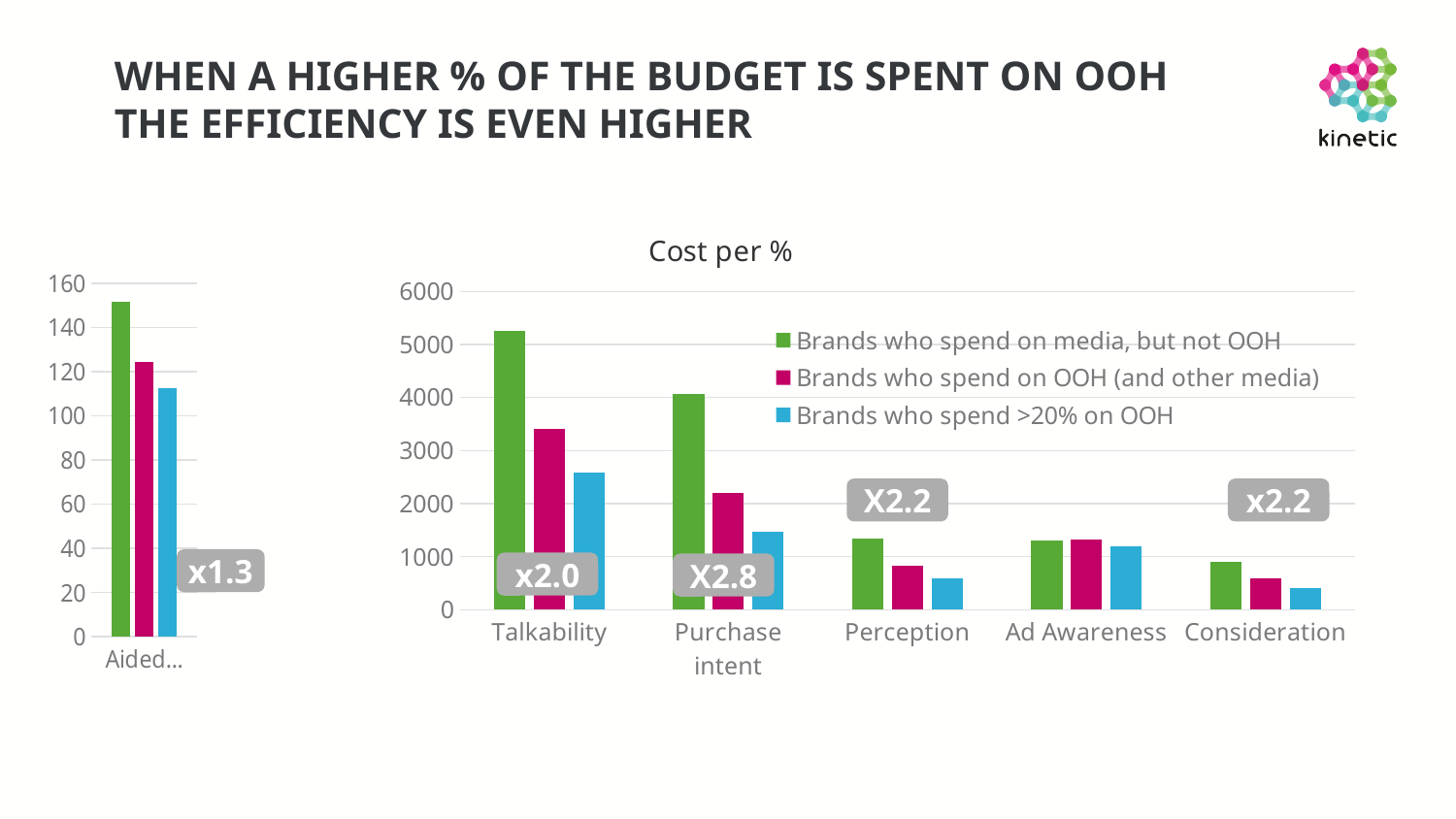
In the "Cost per %" chart, which is larger for "Brands who spend on media, but not OOH": Talkability or Purchase intent? Talkability In the small chart on the left, is the blue bar greater or less than 120? less In the "Cost per %" chart, is the value for "Brands who spend on OOH (and other media)" at Perception greater or less than 1000? less What kind of chart is the "Cost per %" chart? bar chart In the "Cost per %" chart, is the value for "Brands who spend on media, but not OOH" at Talkability greater or less than 5000? greater How many series does the legend of the "Cost per %" chart list? 3 In the "Cost per %" chart, do the values for "Brands who spend on media, but not OOH" rise or fall from Talkability to Consideration? fall In the "Cost per %" chart, which category has the highest value for "Brands who spend on media, but not OOH"? Talkability How many categories are shown on the x axis of the "Cost per %" chart? 5 What is the title of the chart on the right? Cost per %